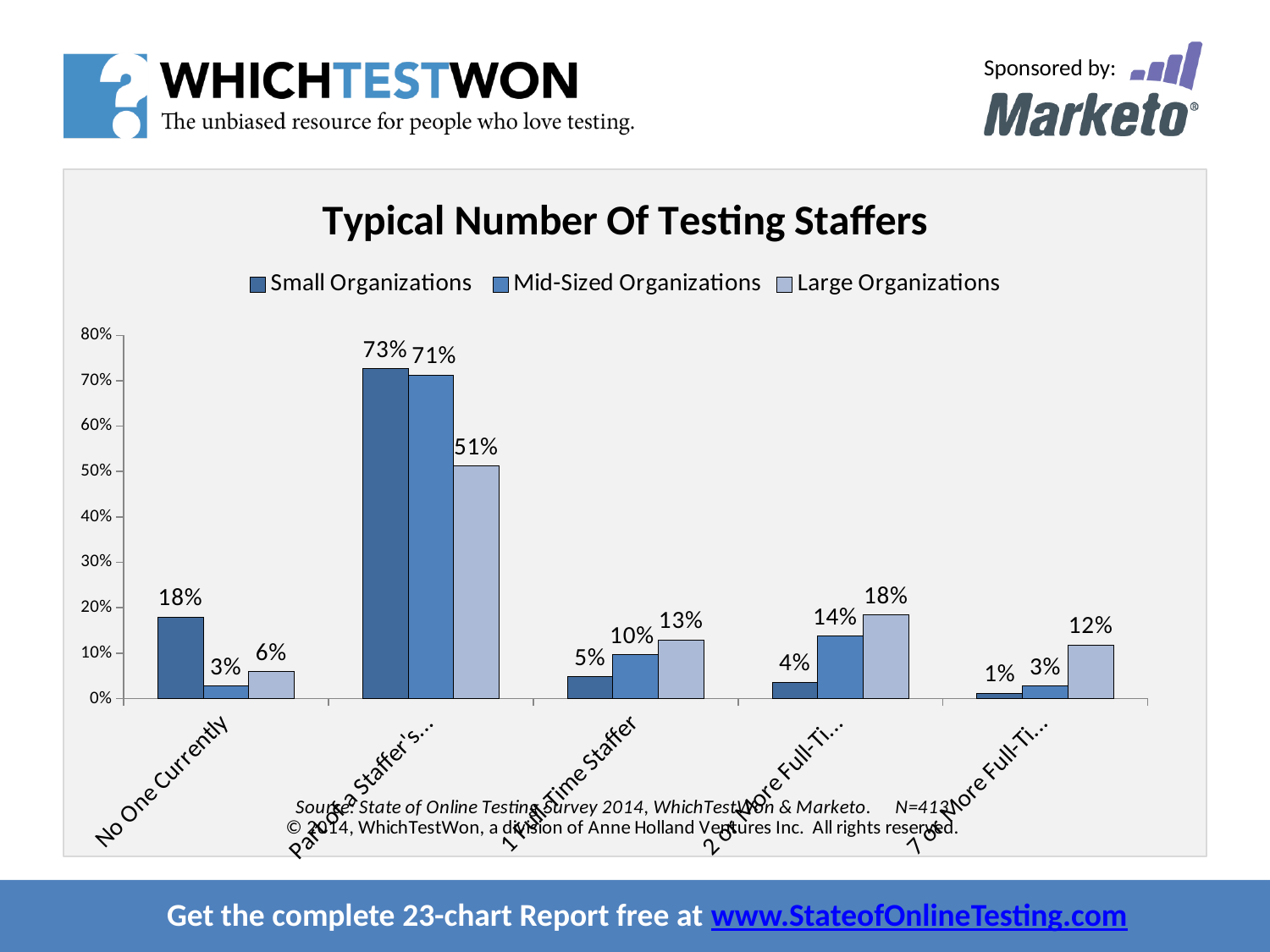
In the '1 Full-Time Staffer' category, which is larger: Mid-Sized Organizations or Large Organizations? Large Organizations Which category has the highest value for Small Organizations? Part of a Staffer's... How many series does the legend list? 3 Which series has the lowest value in the '1 Full-Time Staffer' category? Small Organizations What is the value for Large Organizations in the '1 Full-Time Staffer' category? 13% What kind of chart is this? Bar chart How many categories are shown on the x axis? 5 What is the value for Small Organizations in the 'No One Currently' category? 18% What is the value for Mid-Sized Organizations in the 'No One Currently' category? 3% Is the Large Organizations value in the second category (Part of a Staffer's...) greater or less than 60%? less What is the difference between the Small Organizations and Large Organizations values in the 'No One Currently' category? 12% What is the title of the chart? Typical Number Of Testing Staffers